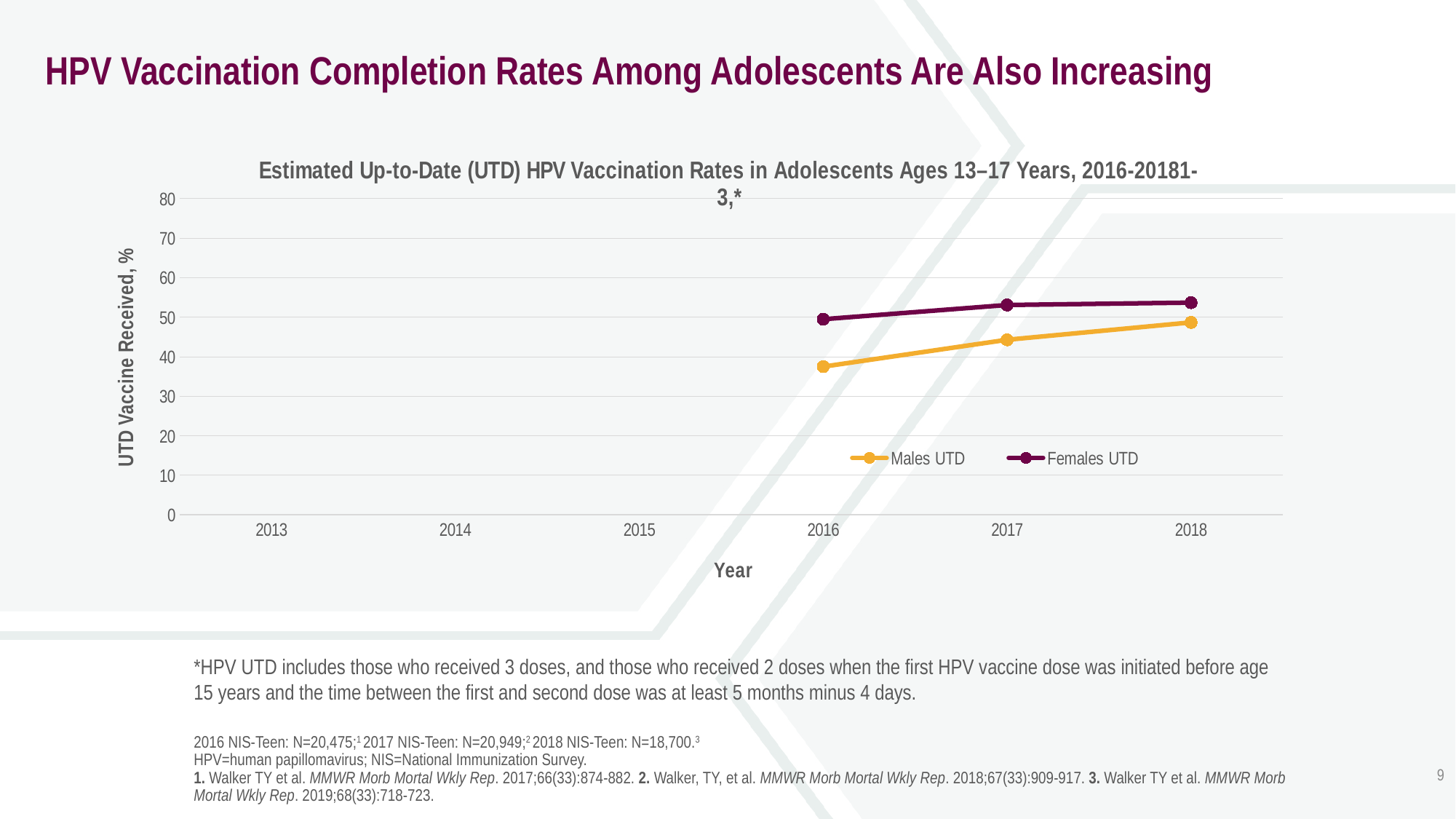
Is the Females UTD value for 2017 greater or less than 50? greater What are the two series named in the legend? Males UTD and Females UTD Do the Males UTD values rise or fall from 2016 to 2018? Rise Is the Males UTD value for 2016 greater or less than 40? less How many series does the legend list? 2 What is the label on the vertical axis? UTD Vaccine Received, % Which series has the higher value in 2018, Males UTD or Females UTD? Females UTD What kind of chart is shown on the slide? Line chart For how many years are data points plotted for each series? 3 In which year is the Females UTD value lowest? 2016 In which year is the Males UTD value highest? 2018 Which series has the higher value in 2016, Males UTD or Females UTD? Females UTD